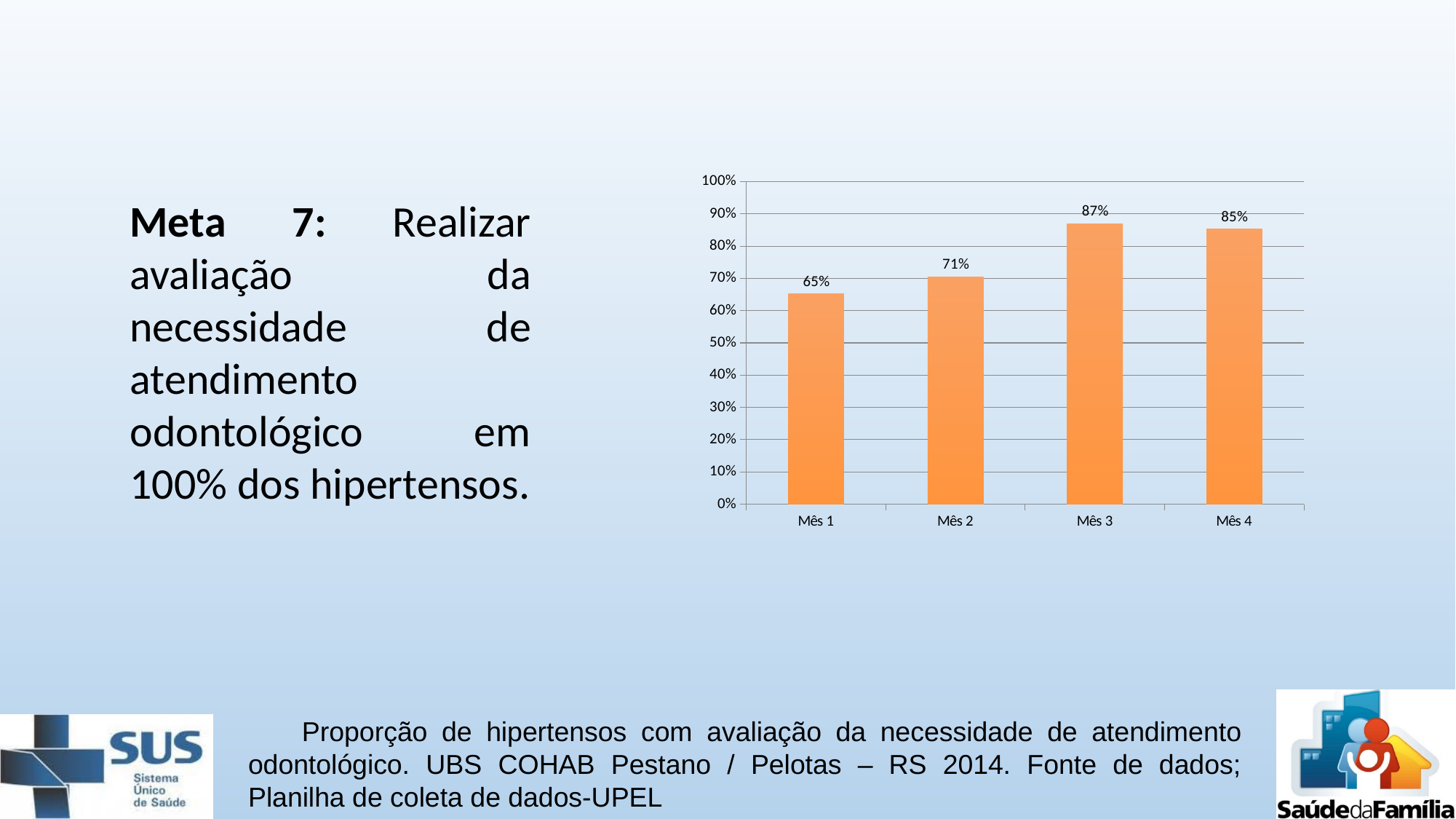
What is the difference between the values for Mês 3 and Mês 1? 22% What is the value for Mês 3? 87% What is the difference between the values for Mês 2 and Mês 1? 6% What is the value for Mês 4? 85% How many months are shown on the x axis? 4 What colour are the bars in the chart? Orange Which is larger, the value for Mês 2 or the value for Mês 4? Mês 4 What kind of chart is shown on the slide? Bar chart What is the value for Mês 1? 65% Which month has the lowest value? Mês 1 Which month has the highest value? Mês 3 What is the value for Mês 2? 71%